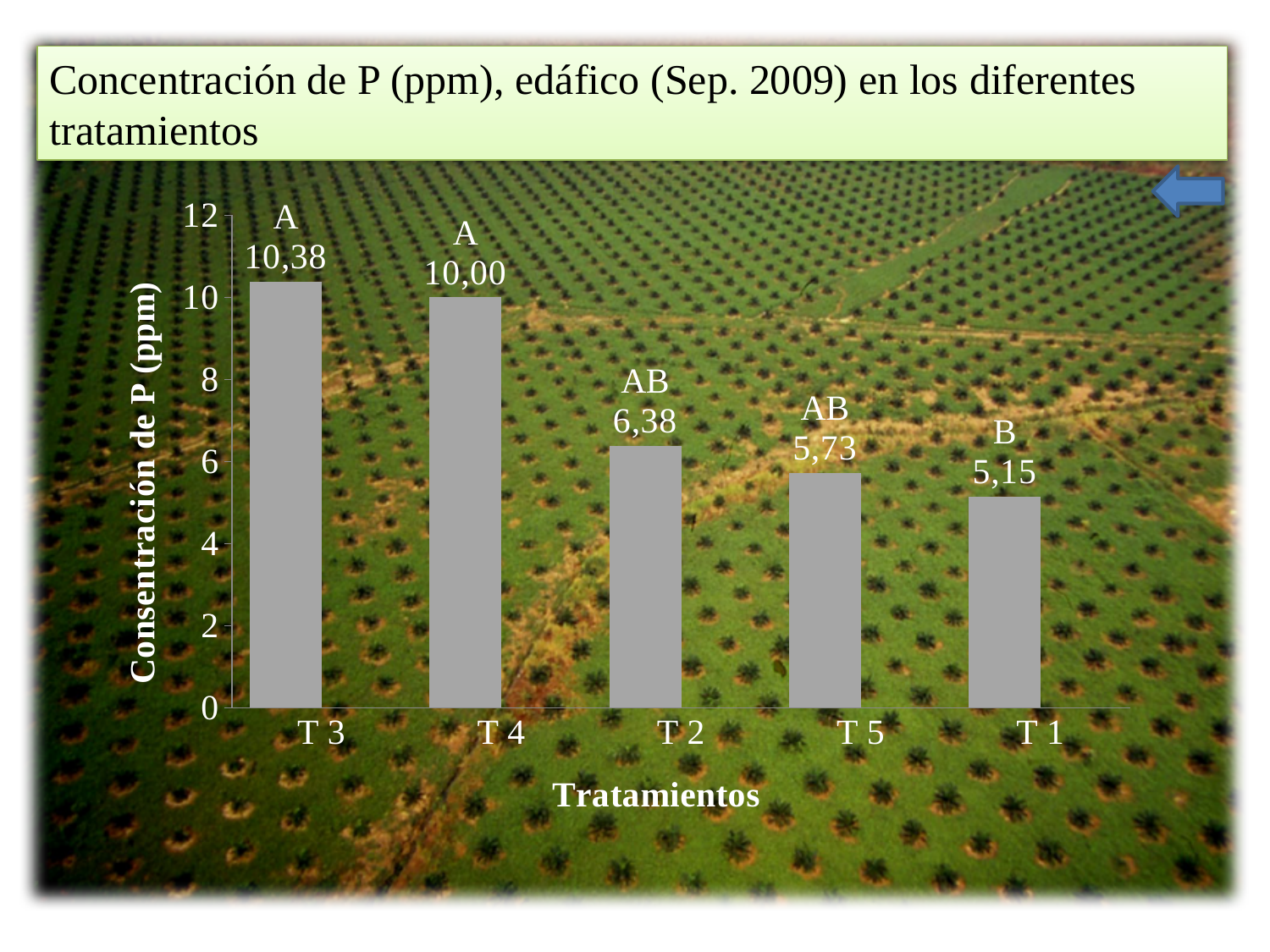
What is the value labelled on the bar for T 5? 5,73 What statistical grouping letter is shown above the bar for T 1? B Do the bar values rise or fall from left to right along the x axis? Fall Which treatment has the lowest P concentration? T 1 How many treatments are plotted on the chart? 5 What is the difference between the values for T 3 and T 4? 0,38 What is the P concentration value shown for treatment T 3? 10,38 What is the difference between the values for T 2 and T 1? 1,23 Which has a higher P concentration, T 2 or T 5? T 2 What is the value shown for treatment T 1? 5,15 What kind of chart is shown on the slide? Bar chart Which treatment has the highest P concentration? T 3